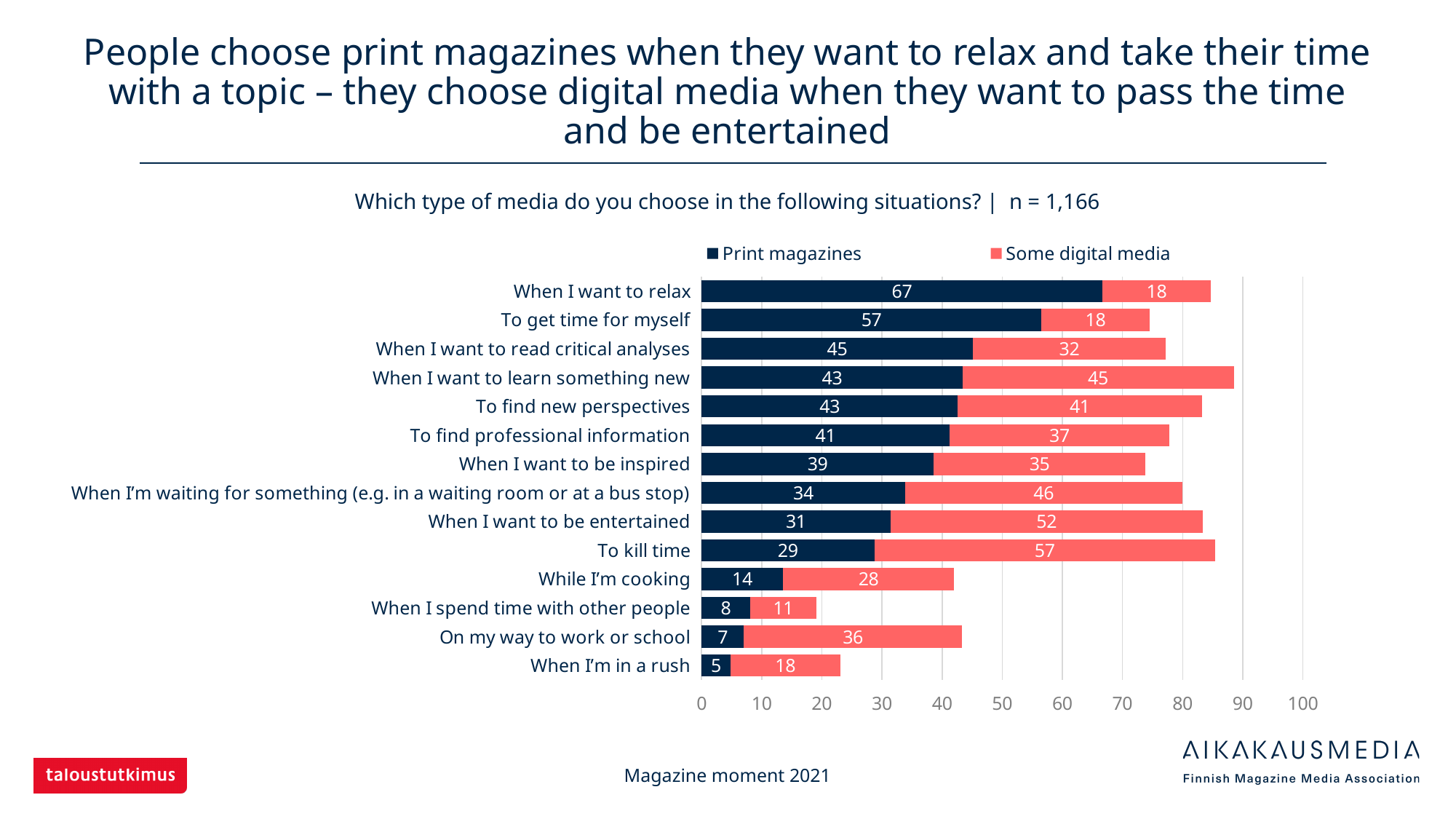
What is the difference between the Print magazines and Some digital media values for "When I want to be entertained"? 21 What is the sample size (n) stated in the chart subtitle? n = 1,166 How many categories are shown on the chart? 14 Which category has the highest Print magazines value? When I want to relax Which is larger for "On my way to work or school": Print magazines or Some digital media? Some digital media What is the Some digital media value for "To kill time"? 57 Which category has the lowest Print magazines value? When I'm in a rush What is the total of the stacked bar for "When I want to learn something new"? 88 What is the Print magazines value for "When I want to relax"? 67 What kind of chart is shown on the slide? Stacked bar chart How many series does the legend list? 2 Which category has the highest Some digital media value? To kill time